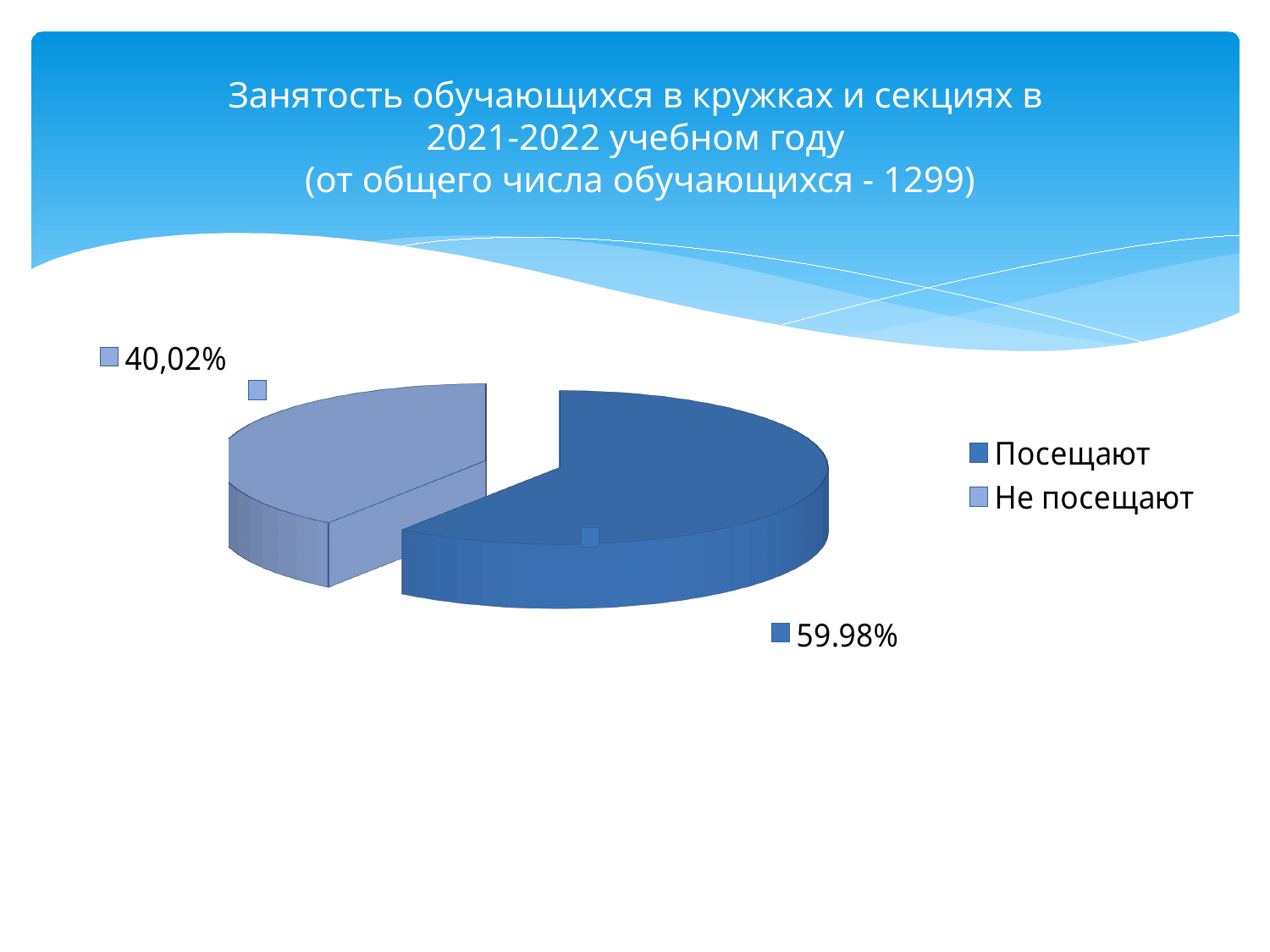
What percentage is shown for the "Посещают" slice? 59.98% How many slices does the pie chart have? 2 Which category has the largest share of the pie? Посещают What total number of students is mentioned in the chart title? 1299 Which category has the smallest share of the pie? Не посещают Which academic year does the chart title refer to? 2021-2022 How many entries does the legend list? 2 What percentage is shown for the "Не посещают" slice? 40,02% What kind of chart is shown on the slide? pie chart What share of the pie does the "Посещают" slice represent? 59.98% Which is larger, the share for "Посещают" or for "Не посещают"? Посещают